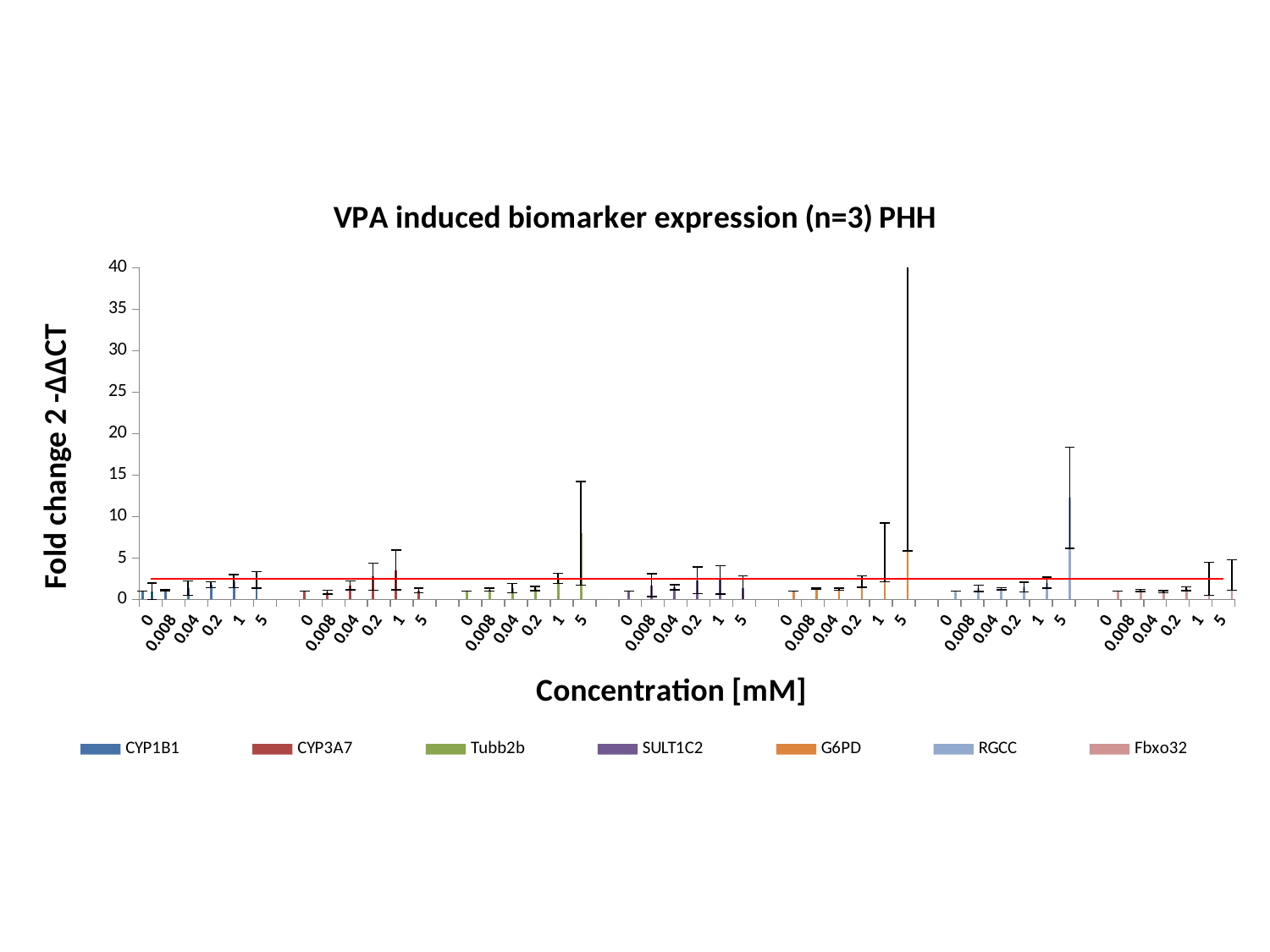
How many concentration levels are plotted for each gene? 6 Is the value for CYP3A7 at 1 mM greater or less than 5? less Within the CYP3A7 series, which concentration has the highest bar? 1 What is the highest value shown on the y axis? 40 Is the value for RGCC at 5 mM greater or less than 10? greater What kind of chart is shown on the slide? bar chart How many series does the legend list? 7 Is the value for G6PD at 5 mM greater or less than 10? greater What is the label of the x axis? Concentration [mM] Within the G6PD series, which concentration has the highest bar? 5 What is the title of the chart? VPA induced biomarker expression (n=3) PHH Within the RGCC series, which concentration has the highest bar? 5